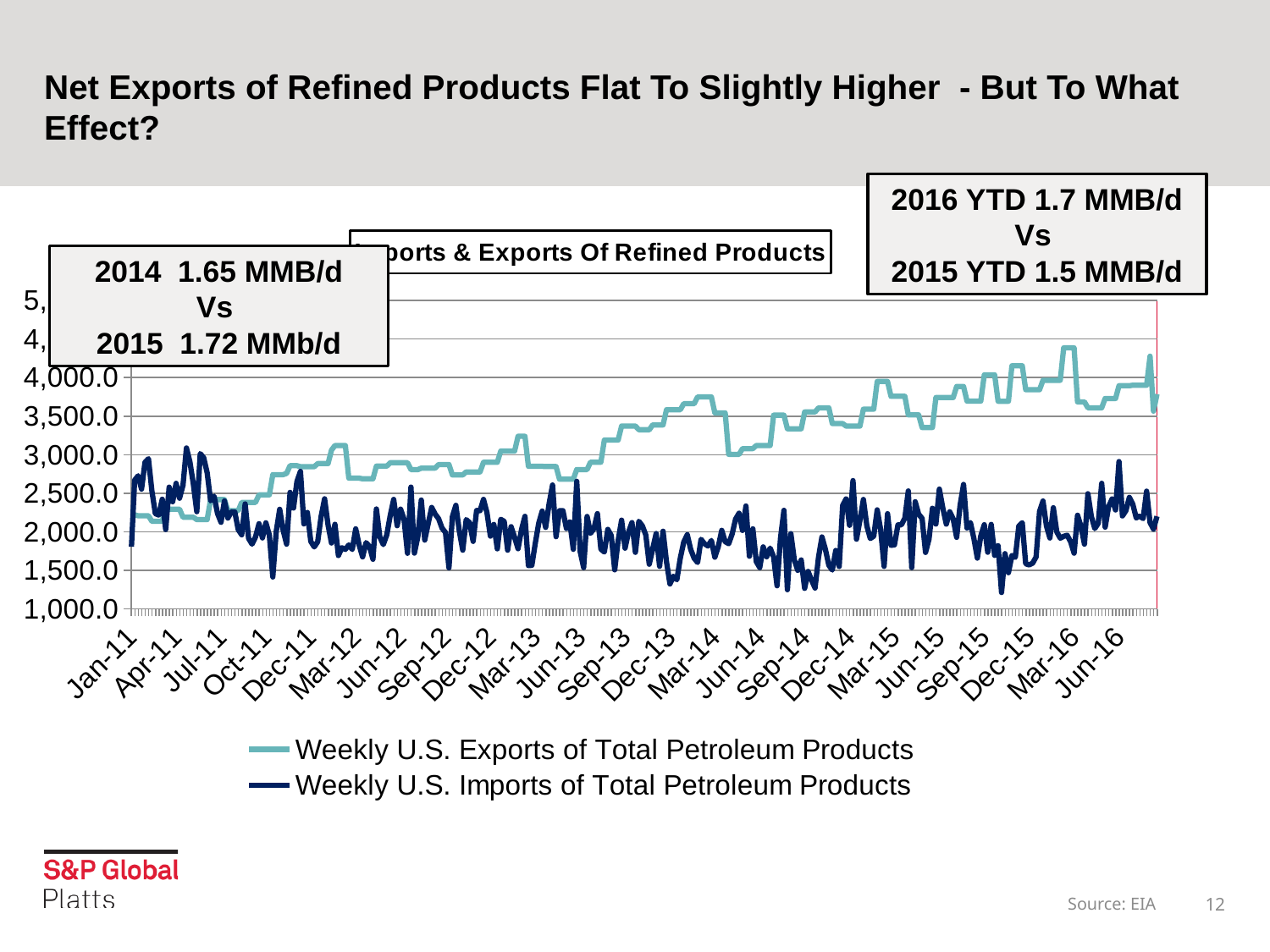
Is the value for Weekly U.S. Exports of Total Petroleum Products around Dec-13 greater or less than 3,000.0? greater Which series is drawn in the light teal line? Weekly U.S. Exports of Total Petroleum Products Is the value for Weekly U.S. Exports of Total Petroleum Products at Jan-11 greater or less than 2,500.0? less What kind of chart is shown on the slide? line chart Do the values for Weekly U.S. Exports of Total Petroleum Products generally rise or fall from Jan-11 to Jun-16? rise At Mar-12, which series has the larger value: Weekly U.S. Exports or Weekly U.S. Imports of Total Petroleum Products? Weekly U.S. Exports of Total Petroleum Products At Jun-16, which series has the larger value: Weekly U.S. Exports or Weekly U.S. Imports of Total Petroleum Products? Weekly U.S. Exports of Total Petroleum Products Is the value for Weekly U.S. Exports of Total Petroleum Products at Jun-16 greater or less than 3,500.0? greater How many series does the chart's legend list? 2 Which series reaches the highest value anywhere on the chart? Weekly U.S. Exports of Total Petroleum Products Which series is drawn in the dark navy line? Weekly U.S. Imports of Total Petroleum Products